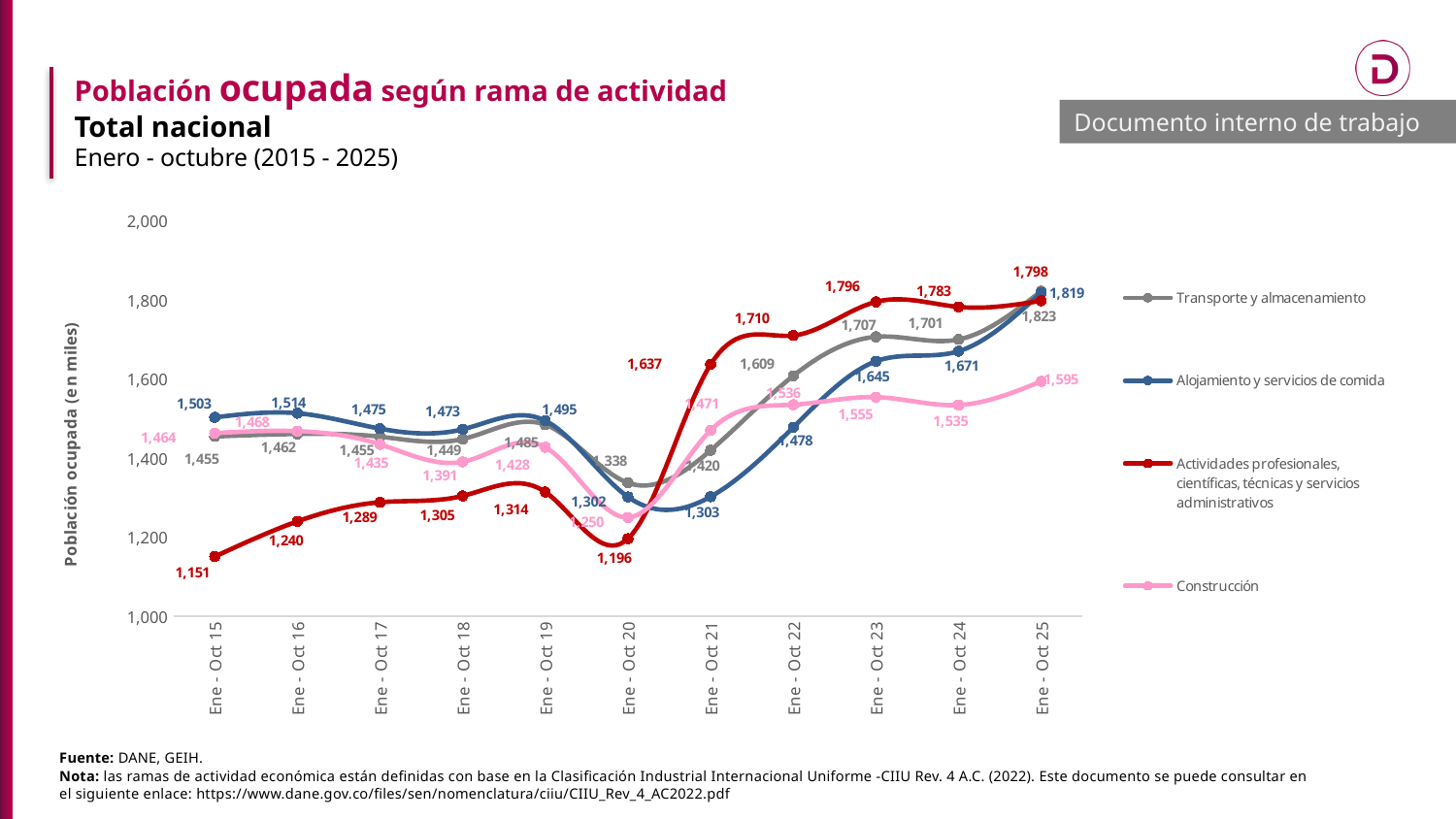
Is the value for Alojamiento y servicios de comida in Ene - Oct 22 greater or less than 1,400? greater What is the value for Construcción in Ene - Oct 24? 1,535 What is the value for Alojamiento y servicios de comida in Ene - Oct 25? 1,819 In which period is the Actividades profesionales, científicas, técnicas y servicios administrativos series at its lowest? Ene - Oct 15 How many series does the legend list? 4 In Ene - Oct 23, which is larger: Transporte y almacenamiento or Alojamiento y servicios de comida? Transporte y almacenamiento How many periods are shown on the x axis? 11 What is the difference between the Transporte y almacenamiento values for Ene - Oct 25 and Ene - Oct 24? 122 In which period is the Transporte y almacenamiento series at its lowest? Ene - Oct 20 What kind of chart is shown on the slide? Line chart What is the value for Actividades profesionales, científicas, técnicas y servicios administrativos in Ene - Oct 15? 1,151 Does the Actividades profesionales, científicas, técnicas y servicios administrativos series rise or fall from Ene - Oct 20 to Ene - Oct 23? Rise